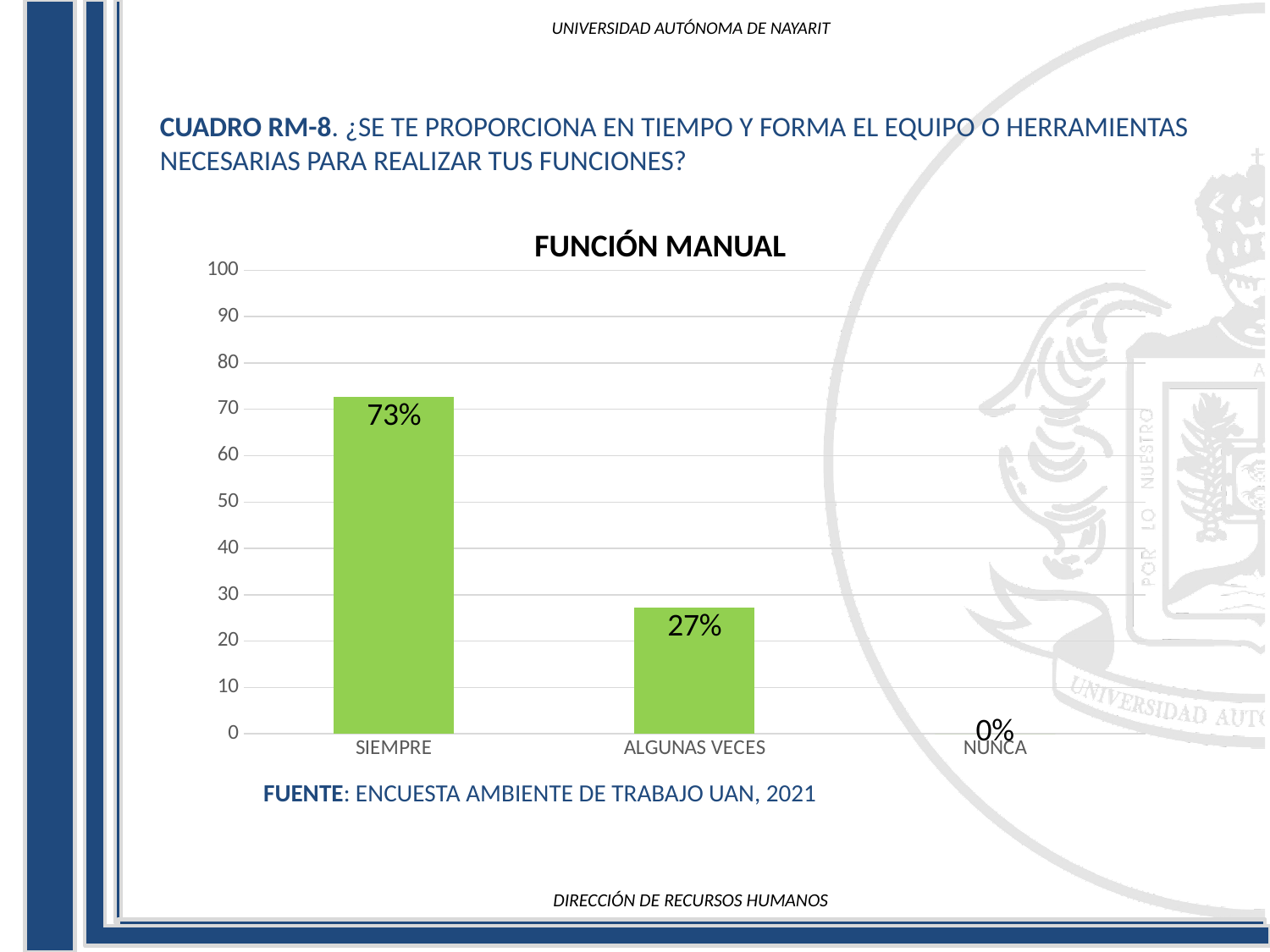
Which category has the highest value? SIEMPRE What is the value for SIEMPRE? 73% Is the value for ALGUNAS VECES greater or less than 30? less What is the value for ALGUNAS VECES? 27% Is the value for SIEMPRE greater or less than 70? greater How many categories are shown on the x axis? 3 Which category has the lowest value? NUNCA Which is larger, the value for SIEMPRE or the value for ALGUNAS VECES? SIEMPRE What is the difference between the values for SIEMPRE and ALGUNAS VECES? 46% What kind of chart is shown? bar chart What is the title of the chart? FUNCIÓN MANUAL What is the value for NUNCA? 0%